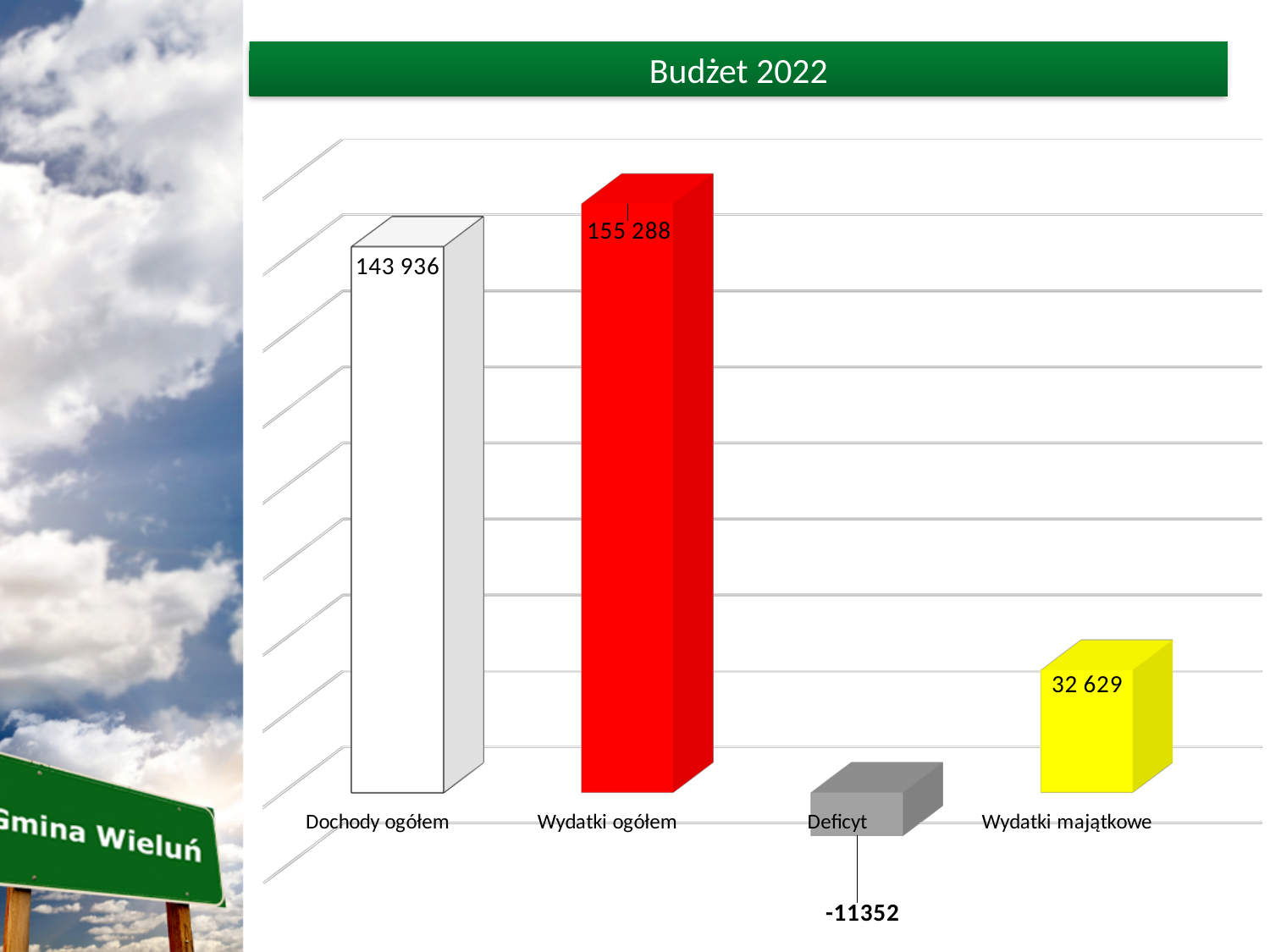
Which category has the lowest value? Deficyt What is the title of the chart? Budżet 2022 What is the value for Wydatki ogółem? 155 288 Which is larger, Dochody ogółem or Wydatki ogółem? Wydatki ogółem What is the value for Wydatki majątkowe? 32 629 Which category has the highest value? Wydatki ogółem What is the difference between Wydatki ogółem and Dochody ogółem? 11 352 What is the difference between Dochody ogółem and Wydatki majątkowe? 111 307 What is the value for Dochody ogółem? 143 936 What is the value for Deficyt? -11352 What kind of chart is shown on the slide? Bar chart How many categories are shown in the chart? 4